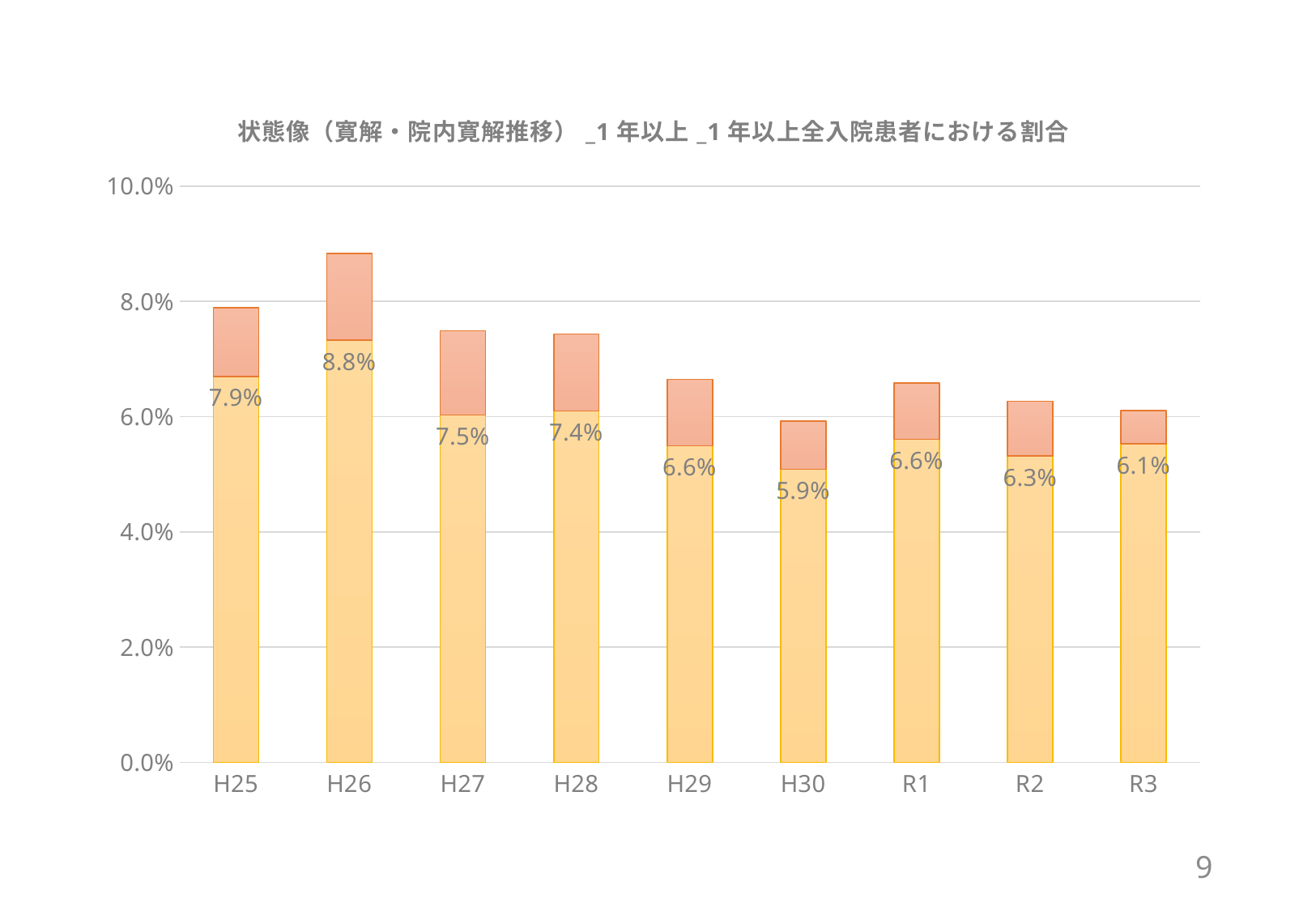
What is the labelled value for H26? 8.8% What is the labelled value for H30? 5.9% What is the labelled value for R3? 6.1% What kind of chart is shown on the slide? Stacked bar chart Which year has the lowest labelled value? H30 Which is larger, the labelled value for H27 or for R2? H27 How many years are shown on the x axis? 9 Which year has the highest labelled value? H26 Is the total bar height for H26 greater or less than 8.0%? greater What is the difference between the labelled values for H26 and H30? 2.9% What is the difference between the labelled values for H25 and R3? 1.8% Do the labelled values generally rise or fall from H26 to H30? Fall